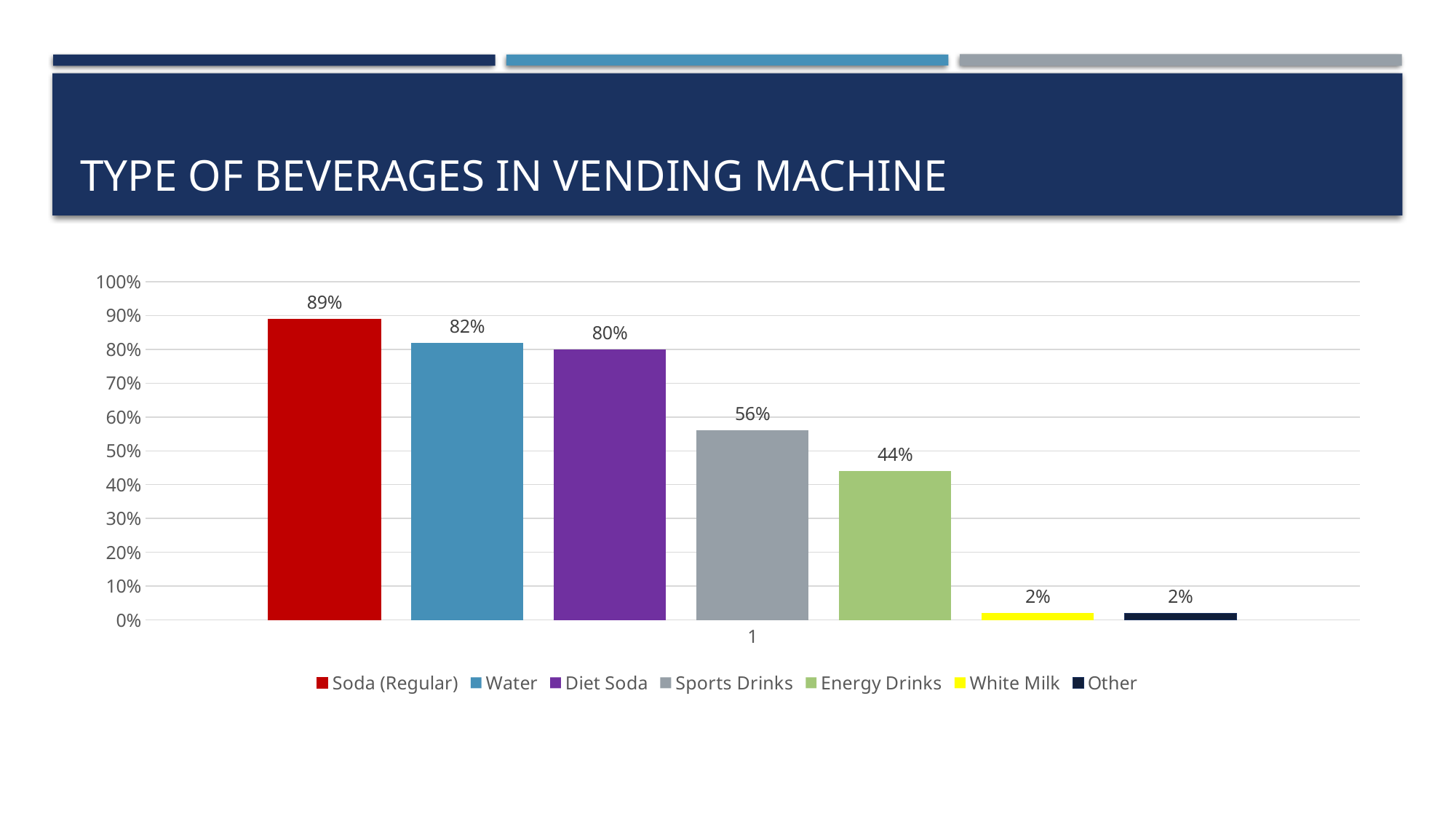
Is the value for Diet Soda greater or less than 70%? greater How many series does the legend list? 7 What kind of chart is shown on the slide? Bar chart What is the difference between the values for Water and Diet Soda? 2% What is the difference between the values for Soda (Regular) and Energy Drinks? 45% Which is larger, the value for Sports Drinks or the value for Energy Drinks? Sports Drinks What is the value for Energy Drinks? 44% What is the title of the slide? TYPE OF BEVERAGES IN VENDING MACHINE What is the value for Sports Drinks? 56% Which beverage type has the highest value? Soda (Regular) What is the value for White Milk? 2% What is the value for Soda (Regular)? 89%